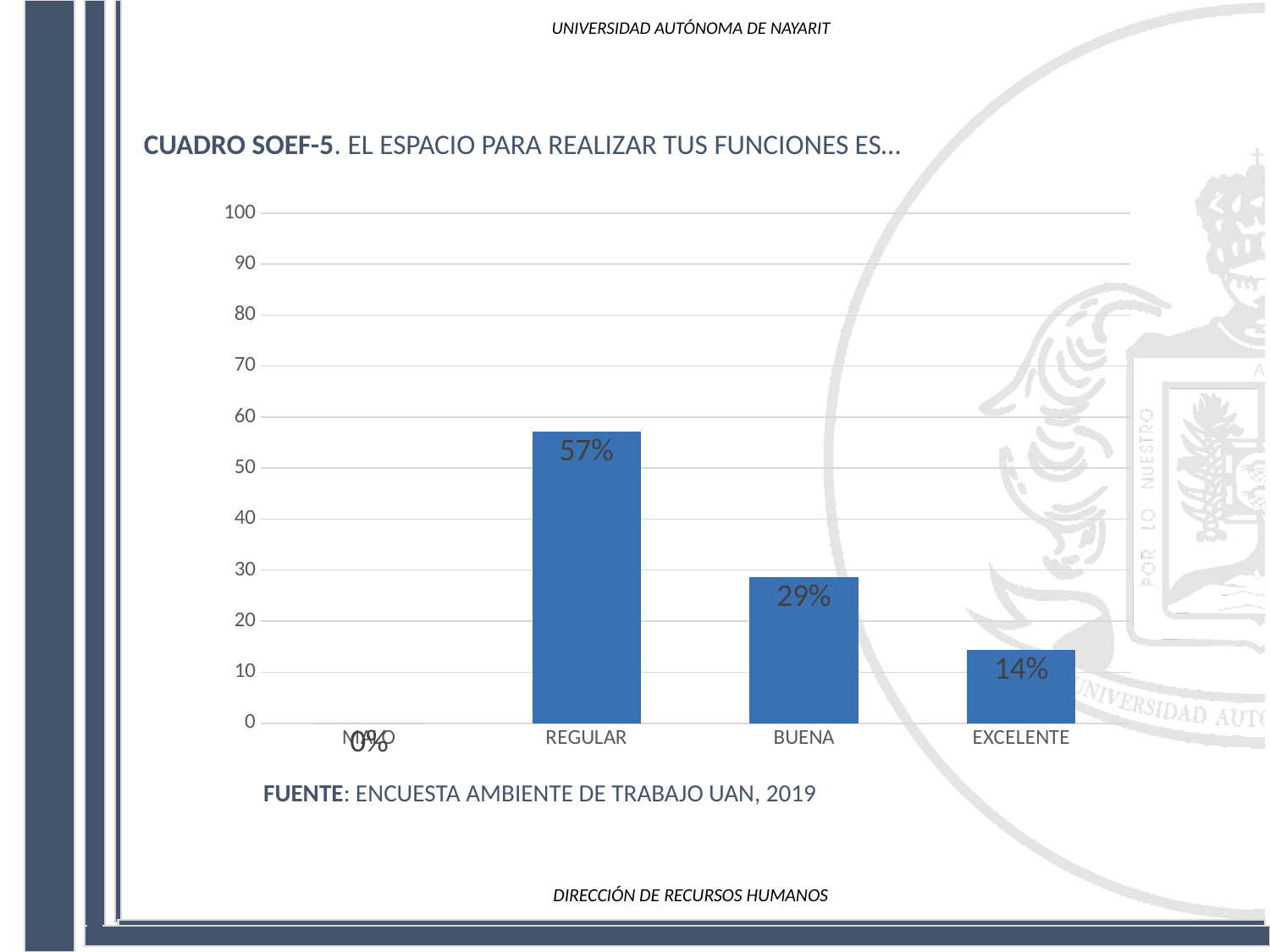
Which category has the highest value? REGULAR What is the value shown for BUENA? 29% What is the difference between the values for REGULAR and BUENA? 28% What is the value shown for EXCELENTE? 14% What kind of chart is shown on the slide? bar chart What source is cited below the chart? ENCUESTA AMBIENTE DE TRABAJO UAN, 2019 Is the value for REGULAR greater or less than 50? greater What percentage of respondents rated the space as REGULAR? 57% Among REGULAR, BUENA and EXCELENTE, which has the lowest value? EXCELENTE How many categories are shown on the x axis? 4 Which is larger, the value for BUENA or the value for EXCELENTE? BUENA What is the difference between the values for BUENA and EXCELENTE? 15%